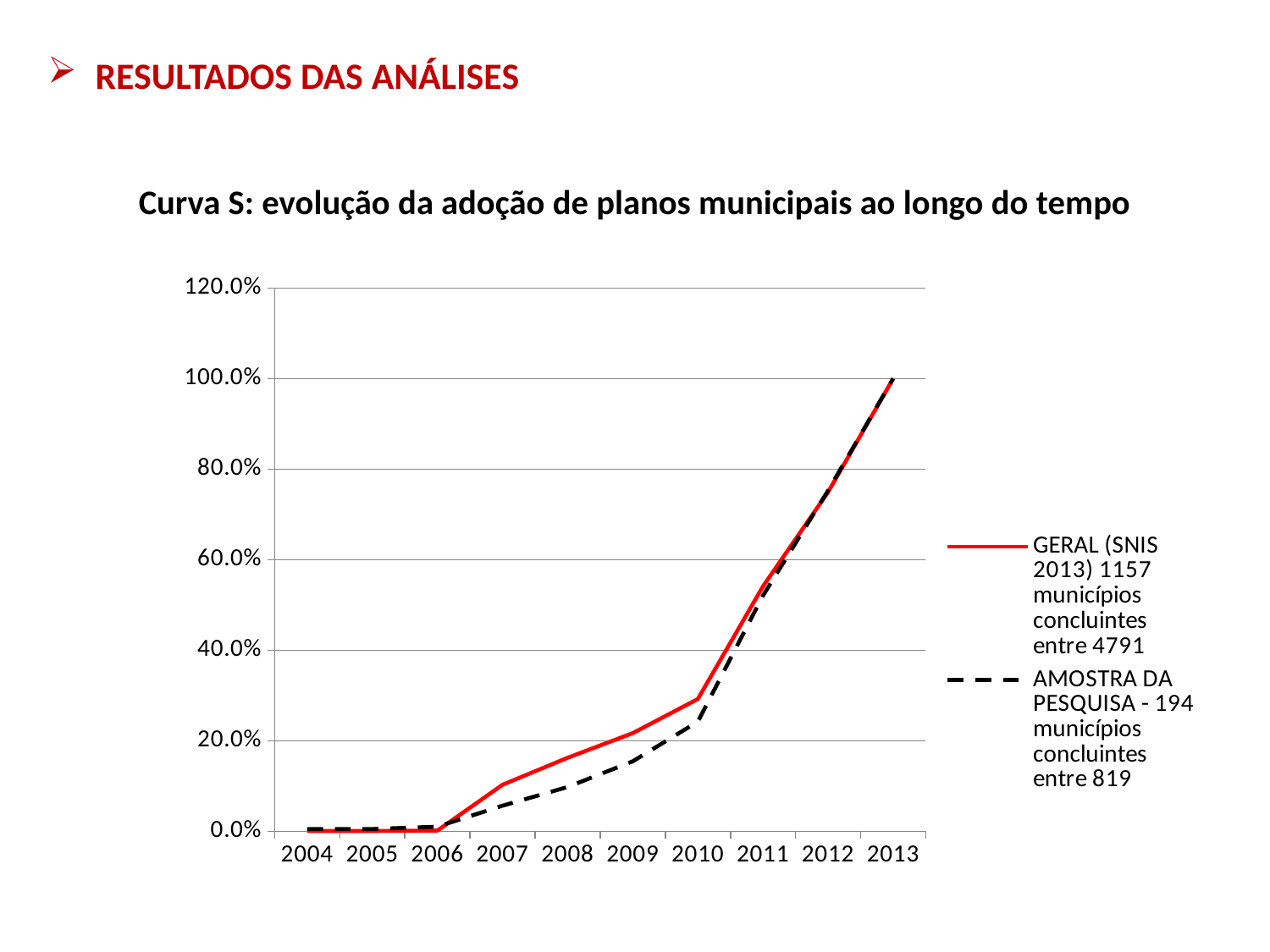
Is the value of the AMOSTRA DA PESQUISA series in 2009 greater or less than 20.0%? less Is the value of the AMOSTRA DA PESQUISA series in 2011 greater or less than 40.0%? greater What is the value of the GERAL (SNIS 2013) series in 2013? 100.0% How many series does the legend list? 2 Do the values of the GERAL (SNIS 2013) series rise or fall from 2004 to 2013? rise Is the value of the GERAL (SNIS 2013) series in 2010 greater or less than 20.0%? greater How many years are shown along the x axis? 10 In 2008, which series has the higher value: GERAL (SNIS 2013) or AMOSTRA DA PESQUISA? GERAL (SNIS 2013) In which year does the GERAL (SNIS 2013) series reach its highest value? 2013 What kind of chart is shown on the slide? line chart What is the title of the chart? Curva S: evolução da adoção de planos municipais ao longo do tempo